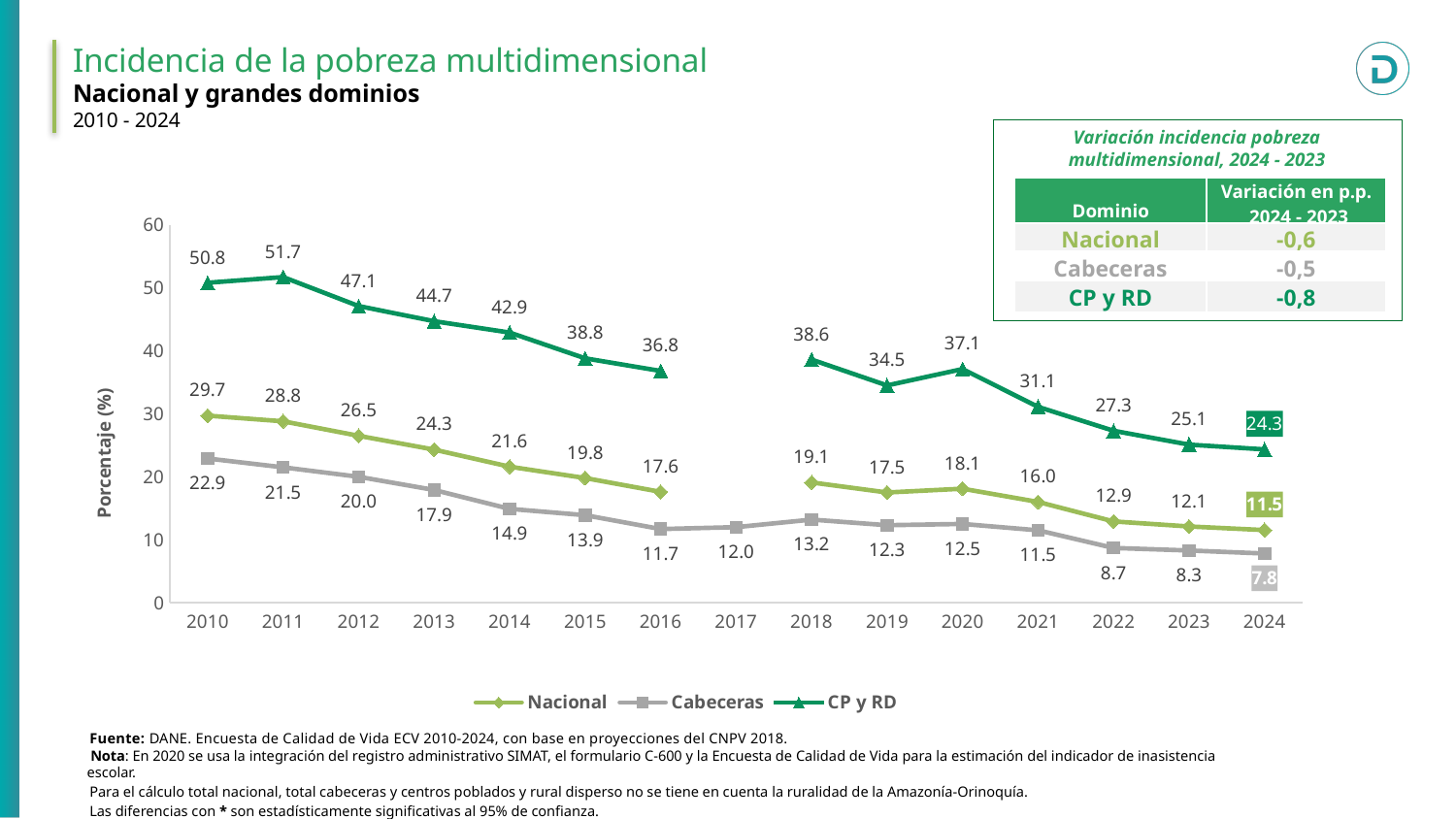
In which year does the CP y RD series reach its highest value? 2011 Does the Nacional series rise or fall from 2010 to 2016? Fall What is the difference between the Nacional value in 2010 and in 2024? 18.2 What is the value for CP y RD in 2010? 50.8 What is the value for Cabeceras in 2013? 17.9 What is the value for Nacional in 2024? 11.5 According to the table on the slide, what is the variation in p.p. 2024 - 2023 for CP y RD? -0,8 How many series does the legend list? 3 Which is larger for CP y RD: the value in 2018 or the value in 2020? 2018 In which year does the Cabeceras series reach its lowest value? 2024 What kind of chart is shown on the slide? Line chart What is the value for Cabeceras in 2017? 12.0